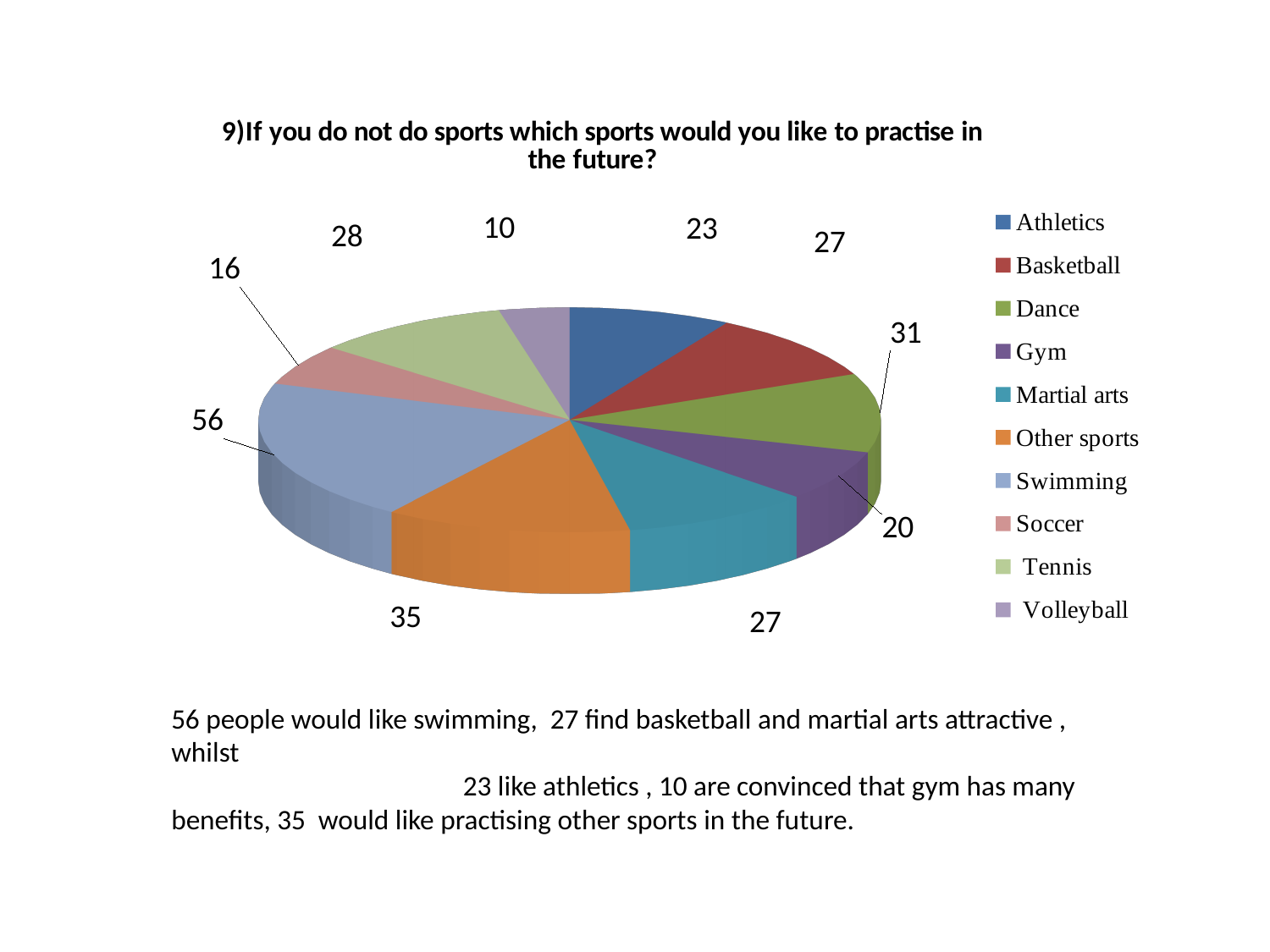
Which sport has the largest slice in the pie chart? Swimming How many categories does the pie chart's legend list? 10 What is the value for Soccer in the pie chart? 16 What is the value for Tennis in the pie chart? 28 What is the value for Other sports in the pie chart? 35 What is the difference between the values for Swimming and Other sports? 21 What is the value for Dance in the pie chart? 31 Which has the larger value, Dance or Tennis? Dance Which sport has the smallest slice in the pie chart? Volleyball What is the value for Athletics in the pie chart? 23 What is the value for Swimming in the pie chart? 56 What kind of chart is shown on the slide? pie chart